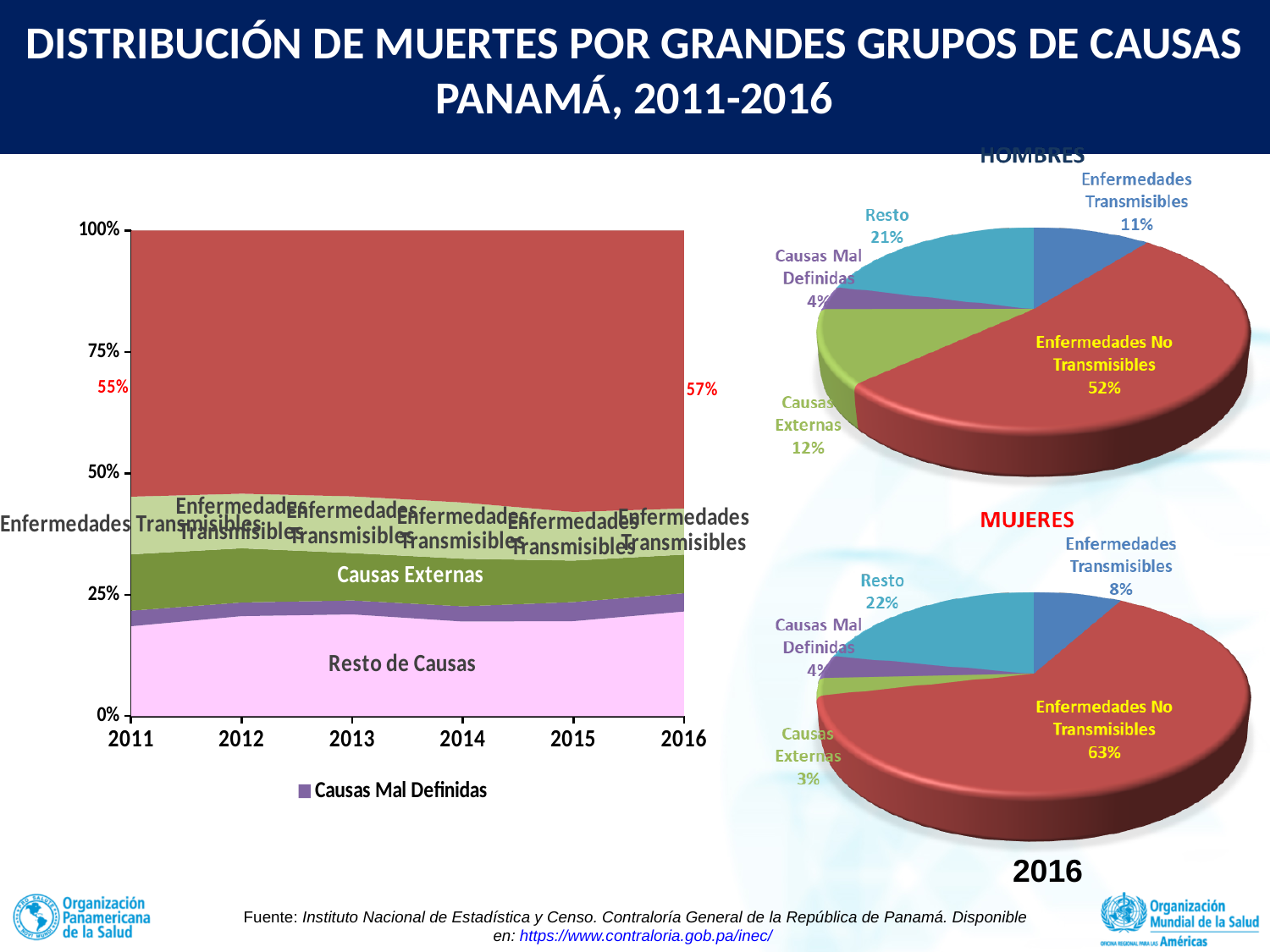
In the left-hand area chart, what value is labeled in red for 2016? 57% How many years are shown on the x axis of the left-hand area chart? 6 How many percentage points higher is the Enfermedades No Transmisibles share in the MUJERES pie chart than in the HOMBRES pie chart? 11 percentage points In the HOMBRES pie chart, what share of deaths is attributed to Enfermedades No Transmisibles? 52% Is the share of Enfermedades Transmisibles larger in the HOMBRES pie chart or in the MUJERES pie chart? HOMBRES How many slices does the HOMBRES pie chart have? 5 What is the only entry shown in the legend below the left-hand area chart? Causas Mal Definidas In the HOMBRES pie chart, which cause group has the largest slice? Enfermedades No Transmisibles In the MUJERES pie chart, which cause group has the smallest slice? Causas Externas What kind of chart is the chart on the left side of the slide showing 2011 to 2016? Stacked area chart In the MUJERES pie chart, what share of deaths is attributed to Causas Externas? 3% In the left-hand area chart, is the value for Resto de Causas in 2011 greater or less than 25%? less